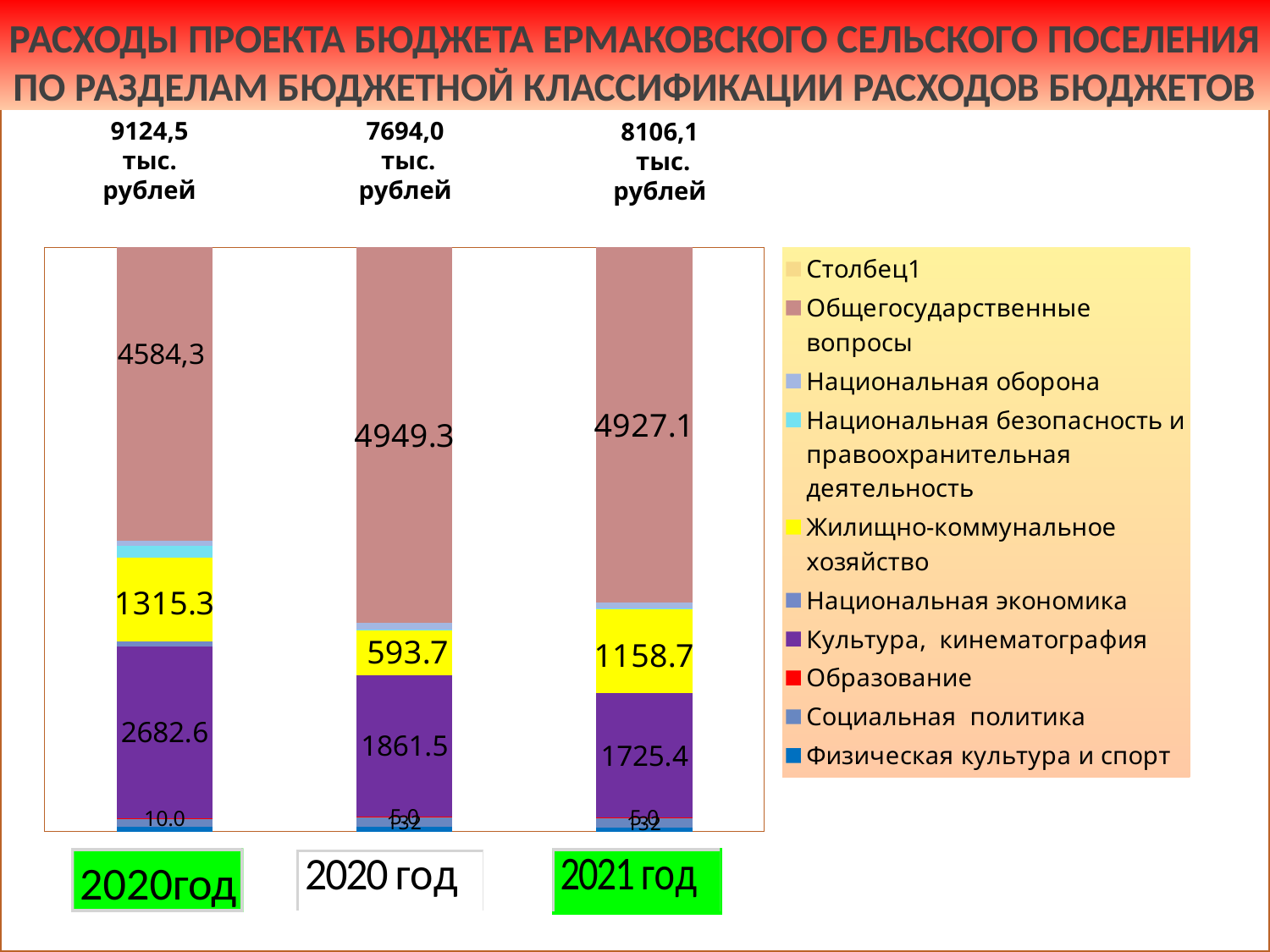
What is the value of the Общегосударственные вопросы segment in the leftmost bar? 4584,3 Which bar has the largest Общегосударственные вопросы segment? The middle bar (4949.3) What is the value of the Жилищно-коммунальное хозяйство segment in the middle bar? 593.7 How many entries does the chart legend list? 10 Is the Жилищно-коммунальное хозяйство value larger in the leftmost bar or in the rightmost bar? The leftmost bar (1315.3) Which bar has the smallest Жилищно-коммунальное хозяйство segment? The middle bar (593.7) What is the value of the Культура, кинематография segment in the rightmost bar (2021 год)? 1725.4 What colour represents Культура, кинематография in the chart? Purple What total is printed above the leftmost bar? 9124,5 тыс. рублей What kind of chart is shown on the slide? Stacked bar chart What is the difference between the Культура, кинематография values in the leftmost bar and the middle bar? 821.1 How many bars are plotted in the chart? 3